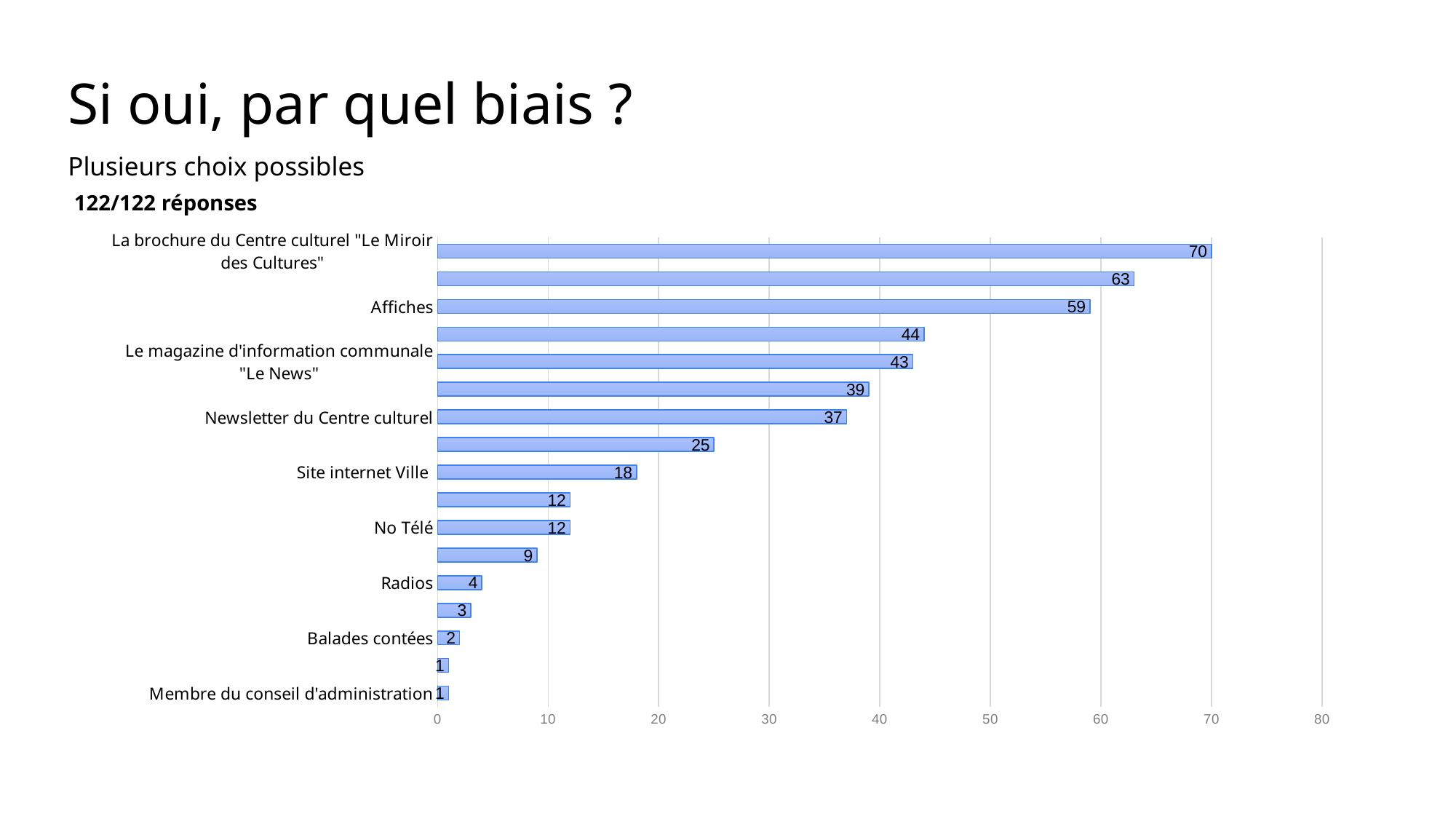
What is the value for Site internet Ville? 18 Which category has the highest value? La brochure du Centre culturel "Le Miroir des Cultures" How many bars are plotted in the chart? 17 How many responses does the slide say the chart is based on? 122/122 réponses Which has a larger value, Affiches or Le magazine d'information communale "Le News"? Affiches What is the value for Newsletter du Centre culturel? 37 What type of chart is shown on the slide? bar chart What is the value for Radios? 4 What is the value for Affiches? 59 Is the value for Newsletter du Centre culturel greater or less than 40? less What is the difference between the values for Affiches and Newsletter du Centre culturel? 22 What is the value for La brochure du Centre culturel "Le Miroir des Cultures"? 70